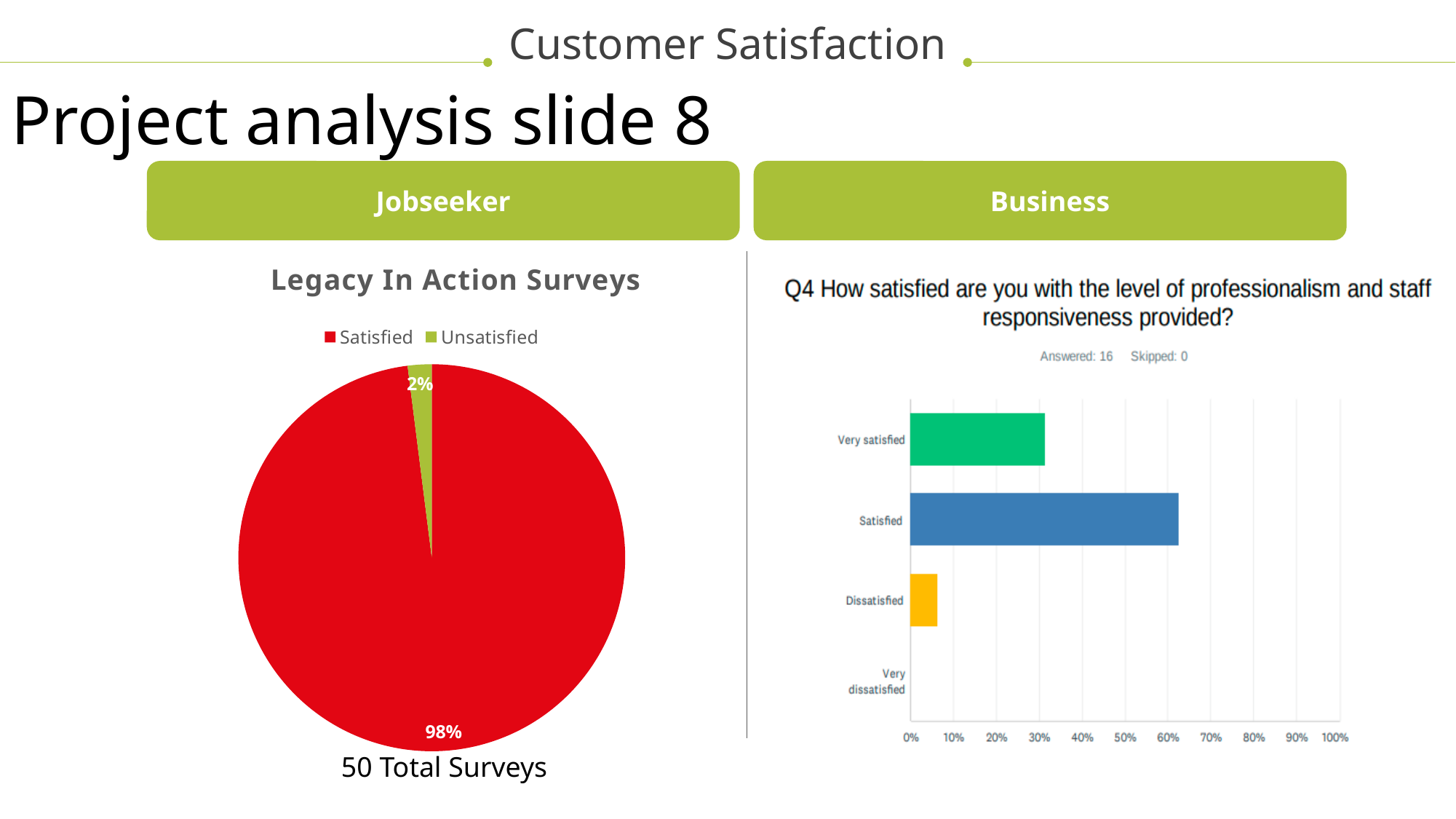
In the Q4 chart on the right, is the value for Satisfied greater or less than 50%? greater In the Legacy In Action Surveys pie chart, what share of responses is Unsatisfied? 2% How many series does the legend of the Legacy In Action Surveys chart list? 2 What kind of chart is the Legacy In Action Surveys chart? Pie chart In the Q4 chart on the right, which is larger, Very satisfied or Dissatisfied? Very satisfied In the Legacy In Action Surveys pie chart, what share of responses is Satisfied? 98% In the Legacy In Action Surveys pie chart, what is the difference between the Satisfied and Unsatisfied shares? 96% In the Legacy In Action Surveys pie chart, which slice is the largest? Satisfied What kind of chart is the Q4 chart on the right of the slide? Bar chart In the Legacy In Action Surveys pie chart, what colour is the Satisfied slice? Red In the Q4 chart on the right, is the value for Dissatisfied greater or less than 10%? less In the Q4 chart on the right, which category has the highest value? Satisfied